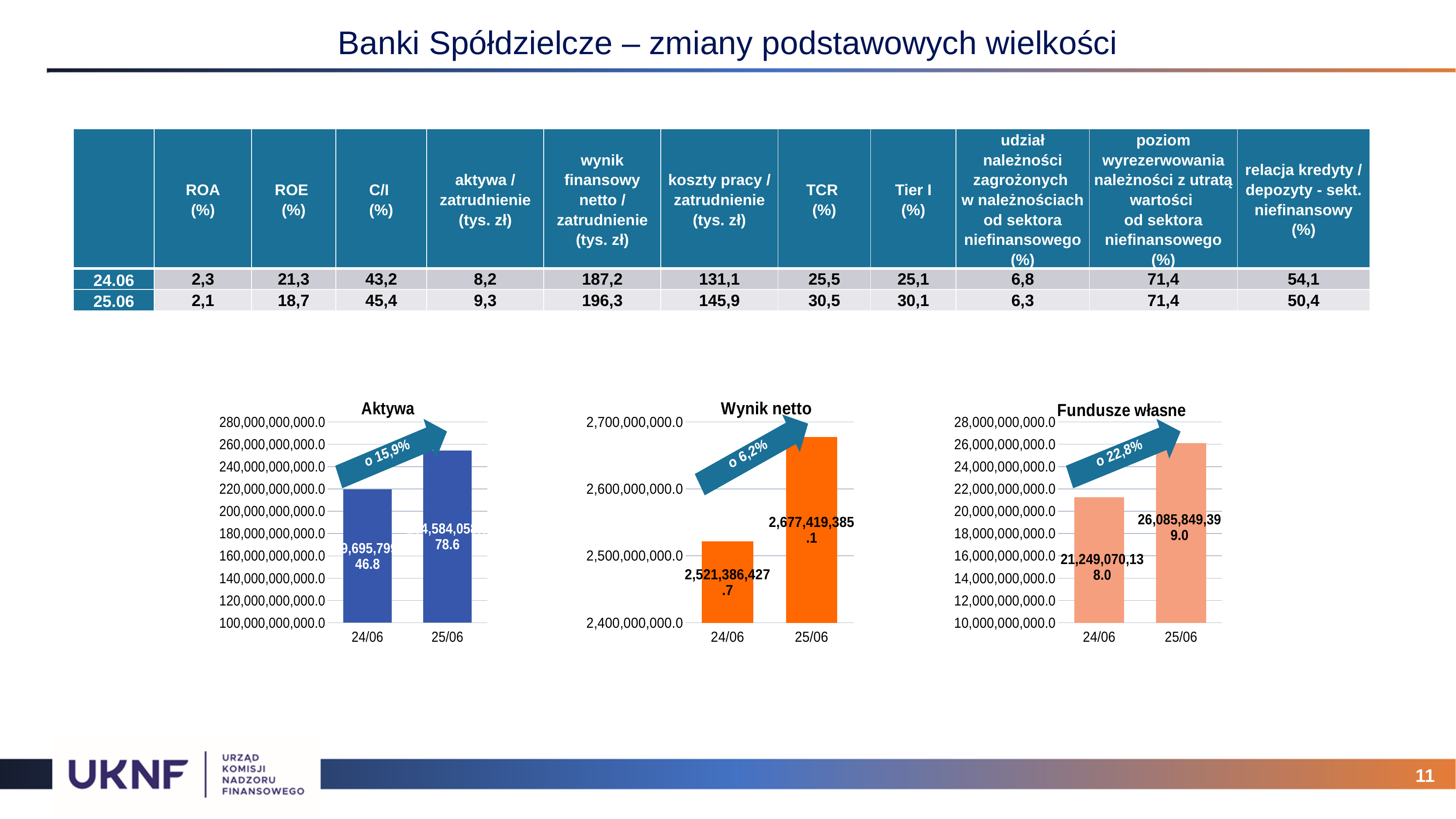
In the Fundusze własne chart, what is the difference between the 25/06 and 24/06 values? 4,836,779,261.0 In the Fundusze własne chart, what is the value for 25/06? 26,085,849,399.0 In the Wynik netto chart, what is the difference between the 25/06 and 24/06 values? 156,032,957.4 How many bars are shown in the Wynik netto chart? 2 In the Fundusze własne chart, what is the value for 24/06? 21,249,070,138.0 What percentage change is written on the arrow in the Fundusze własne chart? o 22,8% What kind of chart is the Fundusze własne chart? bar chart In the Aktywa chart, is the value for 24/06 greater or less than 200,000,000,000.0? greater In the Aktywa chart, is the value for 25/06 greater or less than 240,000,000,000.0? greater In the Aktywa chart, which period has the higher value, 24/06 or 25/06? 25/06 In the Wynik netto chart, what is the value for 24/06? 2,521,386,427.7 In the Wynik netto chart, what is the value for 25/06? 2,677,419,385.1